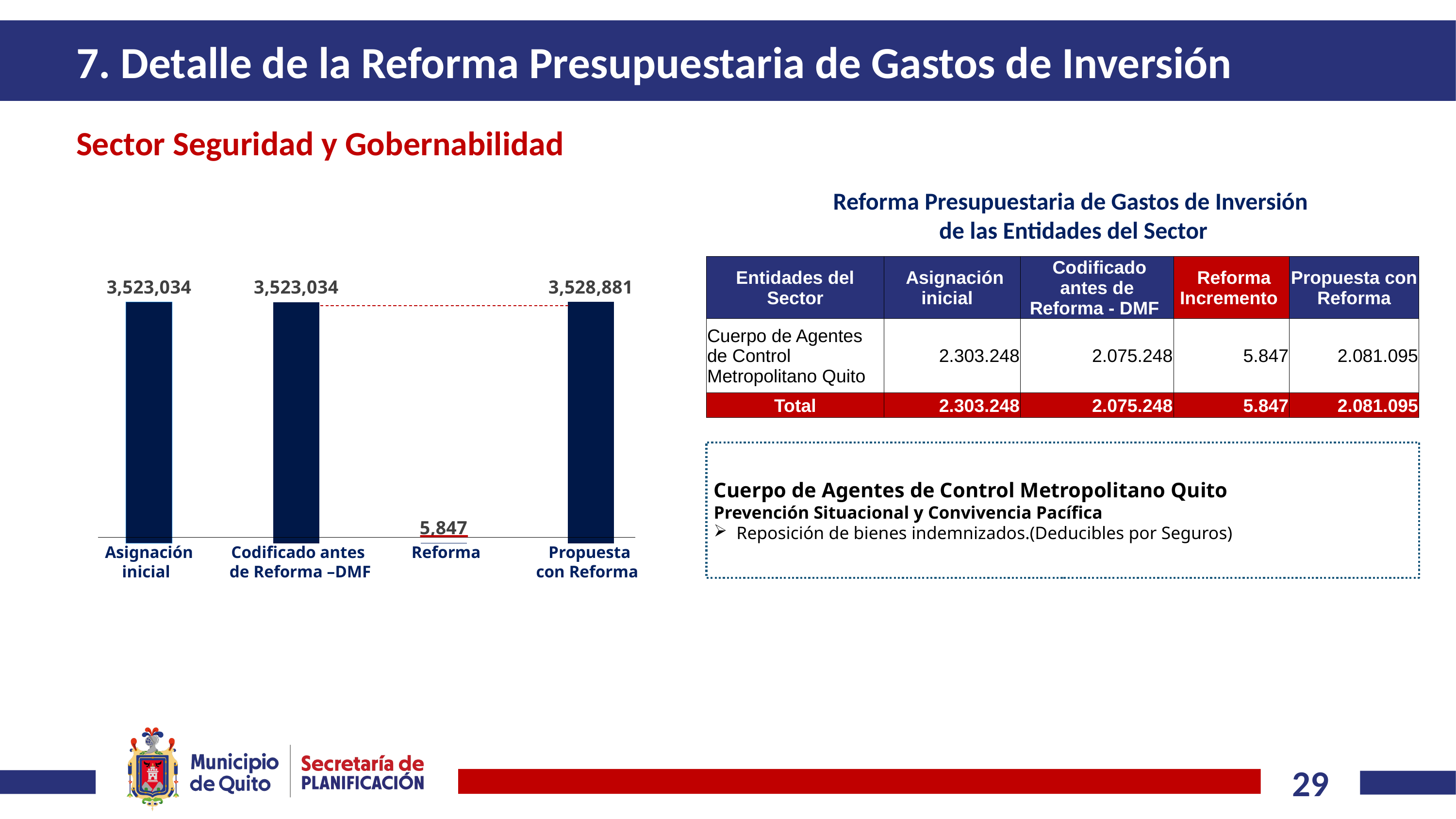
What is the value shown for Propuesta con Reforma in the bar chart? 3,528,881 What colour are the bars for Asignación inicial, Codificado antes de Reforma –DMF and Propuesta con Reforma? Dark navy blue What is the value shown for Codificado antes de Reforma –DMF in the bar chart? 3,523,034 What is the value shown for Reforma in the bar chart? 5,847 Which category has the highest value in the bar chart? Propuesta con Reforma What is the difference between the values for Propuesta con Reforma and Codificado antes de Reforma –DMF? 5,847 What is the difference between the values for Asignación inicial and Codificado antes de Reforma –DMF? 0 What is the value shown for Asignación inicial in the bar chart? 3,523,034 How many categories are shown in the bar chart? 4 Which category has the lowest value in the bar chart? Reforma Which is larger, the value for Propuesta con Reforma or the value for Asignación inicial? Propuesta con Reforma What kind of chart is shown on the left of the slide? Bar chart